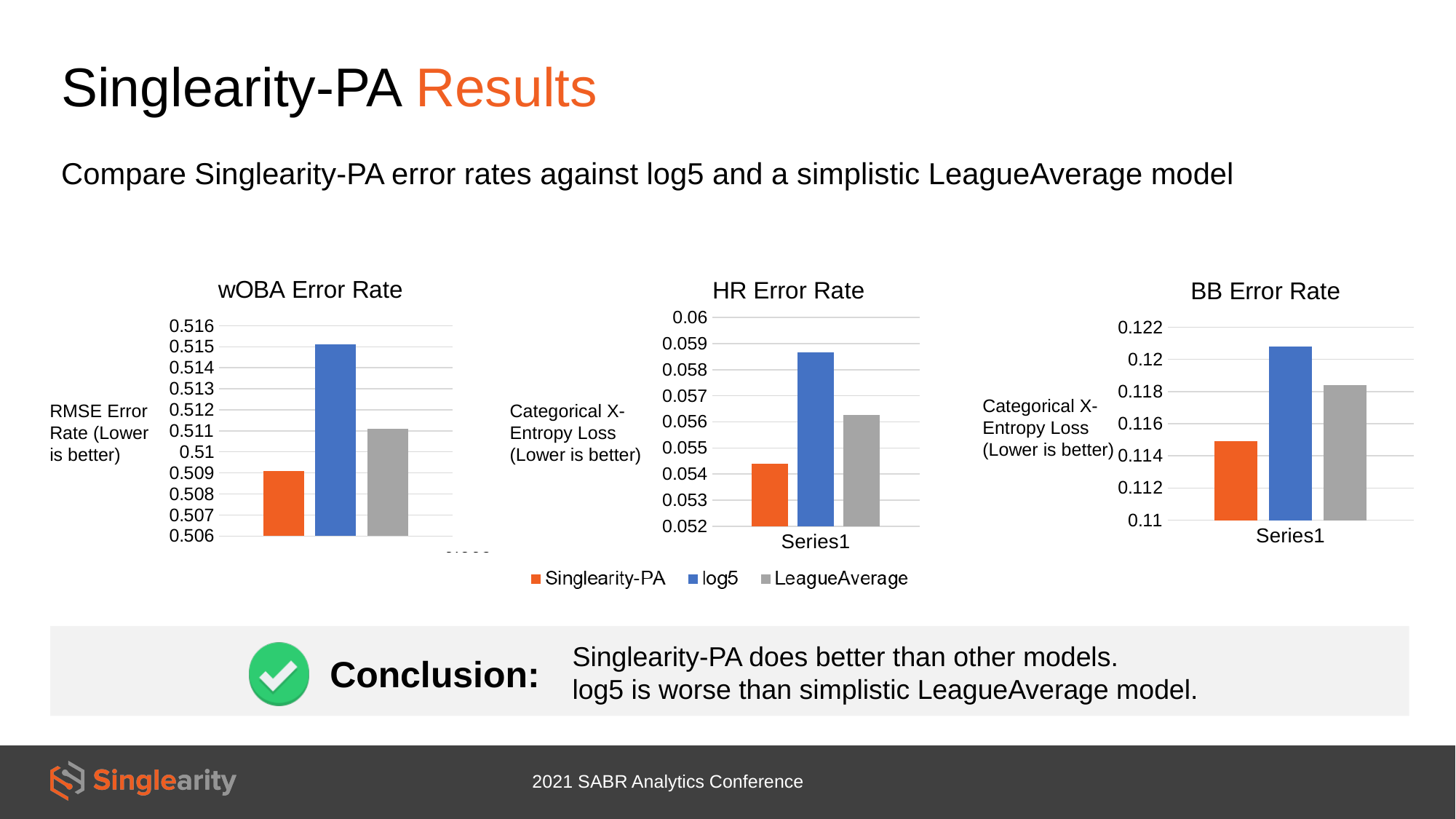
In the wOBA Error Rate chart, is the value for log5 greater or less than 0.514? greater In the BB Error Rate chart, which model has the lowest error rate? Singlearity-PA What kind of chart is the HR Error Rate chart? bar chart In the HR Error Rate chart, which model has the highest error rate? log5 In the BB Error Rate chart, is the value for log5 greater or less than 0.12? greater How many series does the legend list for the error rate charts? 3 In the HR Error Rate chart, is the value for log5 greater or less than 0.058? greater In the wOBA Error Rate chart, which model has the highest error rate? log5 In the BB Error Rate chart, which is larger, the value for LeagueAverage or the value for Singlearity-PA? LeagueAverage In the wOBA Error Rate chart, which model has the lowest error rate? Singlearity-PA